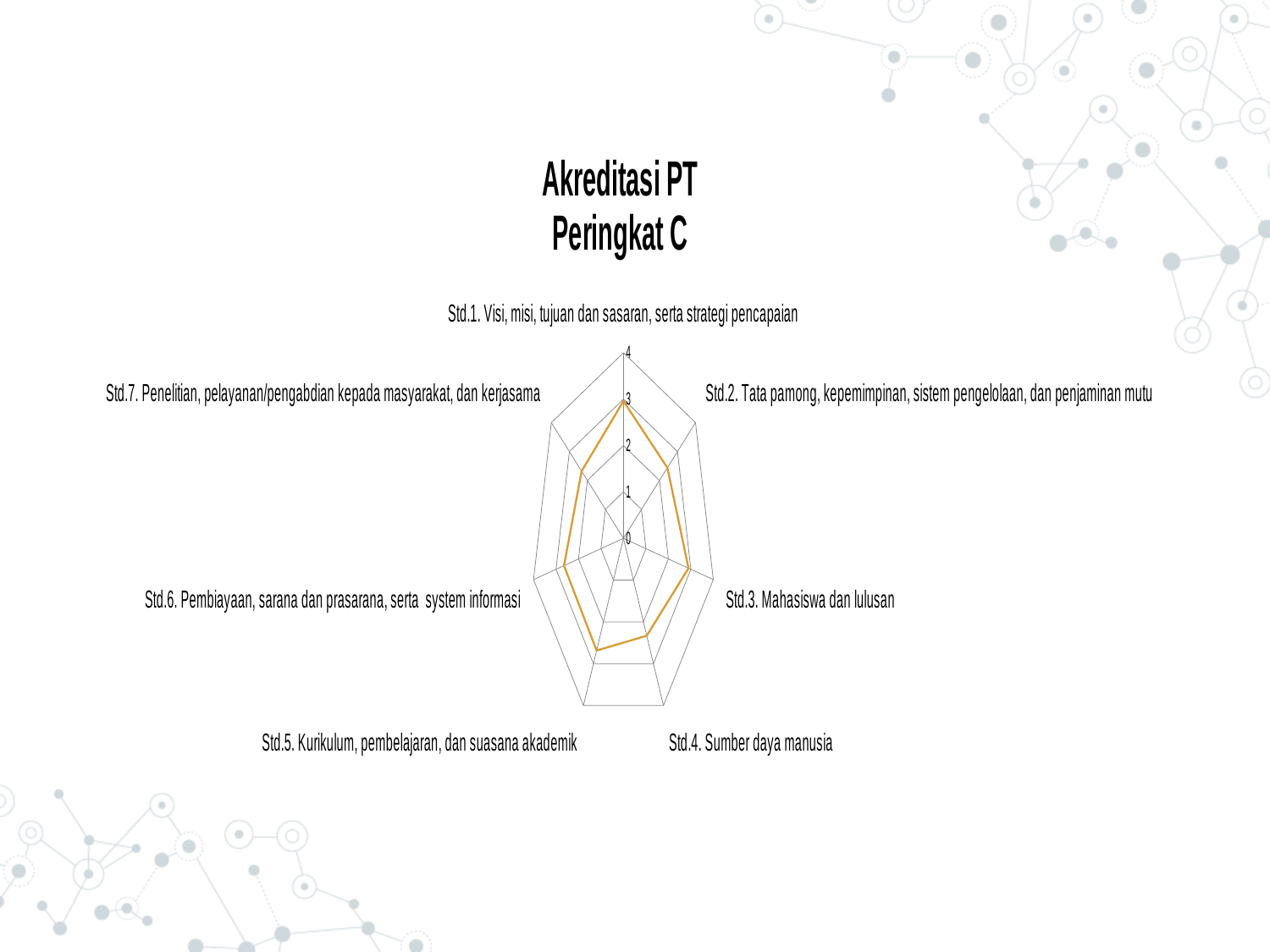
What kind of chart is shown on the slide? Radar chart What is the title of the chart? Akreditasi PT Peringkat C How many categories (standards) are plotted on the radar chart? 7 Is the value for Std.2 (Tata pamong, kepemimpinan, sistem pengelolaan, dan penjaminan mutu) greater or less than 2? greater Is the value for Std.6 (Pembiayaan, sarana dan prasarana, serta system informasi) greater or less than 2? greater Is the value for Std.1 (Visi, misi, tujuan dan sasaran, serta strategi pencapaian) greater or less than 2? greater What is the highest value shown on the chart's axis scale? 4